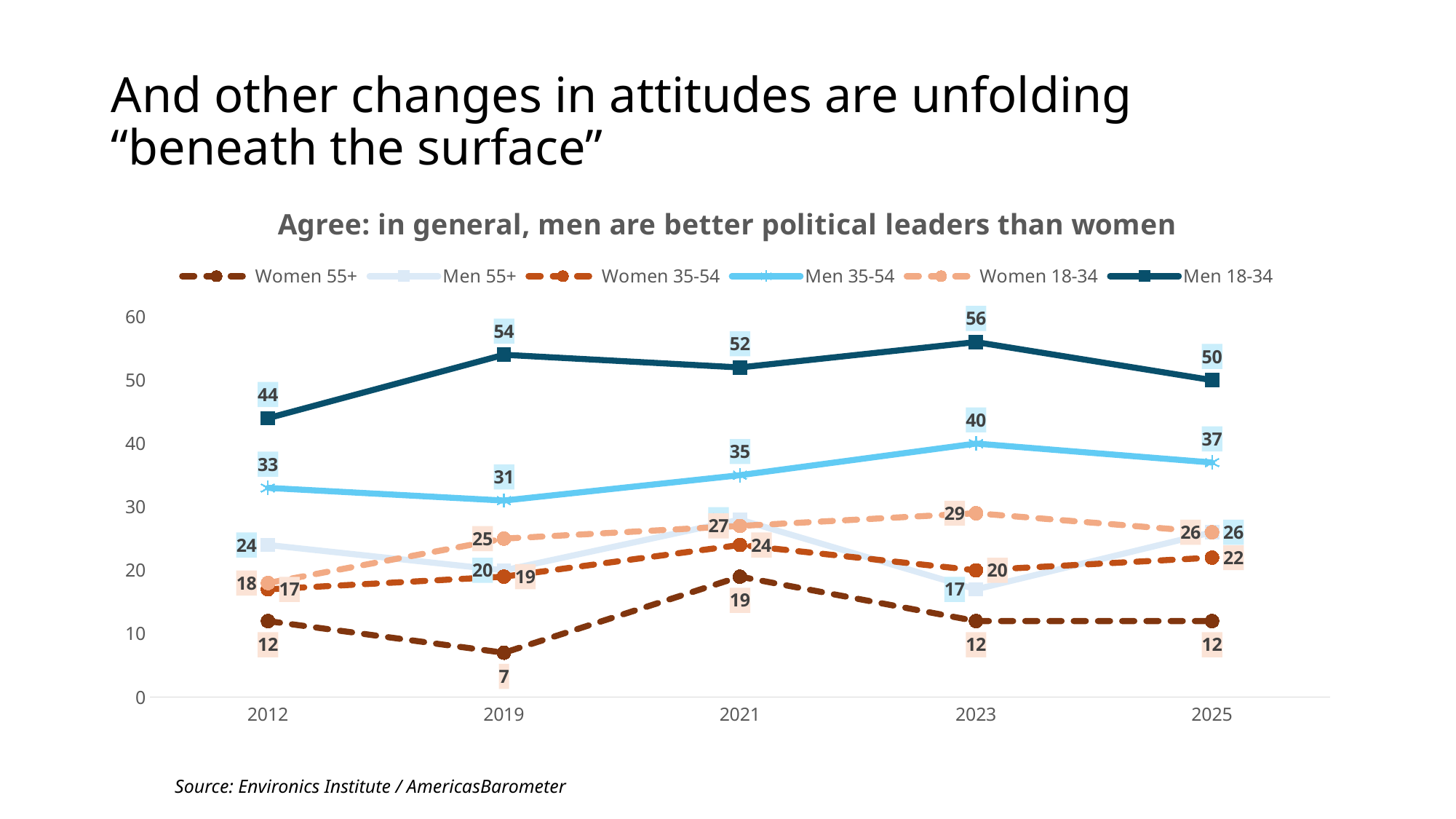
In which year is the value for Women 55+ lowest? 2019 What is the value for Men 55+ in 2023? 17 What is the title of the chart? Agree: in general, men are better political leaders than women How many years are shown on the x axis? 5 What is the value for Men 18-34 in 2023? 56 Does the value for Men 35-54 rise or fall from 2019 to 2023? rise What kind of chart is shown on the slide? line chart What is the difference between the Men 18-34 values in 2025 and 2012? 6 In 2025, which is larger: the value for Men 35-54 or the value for Women 18-34? Men 35-54 How many series does the legend list? 6 In which year is the value for Men 18-34 highest? 2023 What is the value for Women 35-54 in 2021? 24